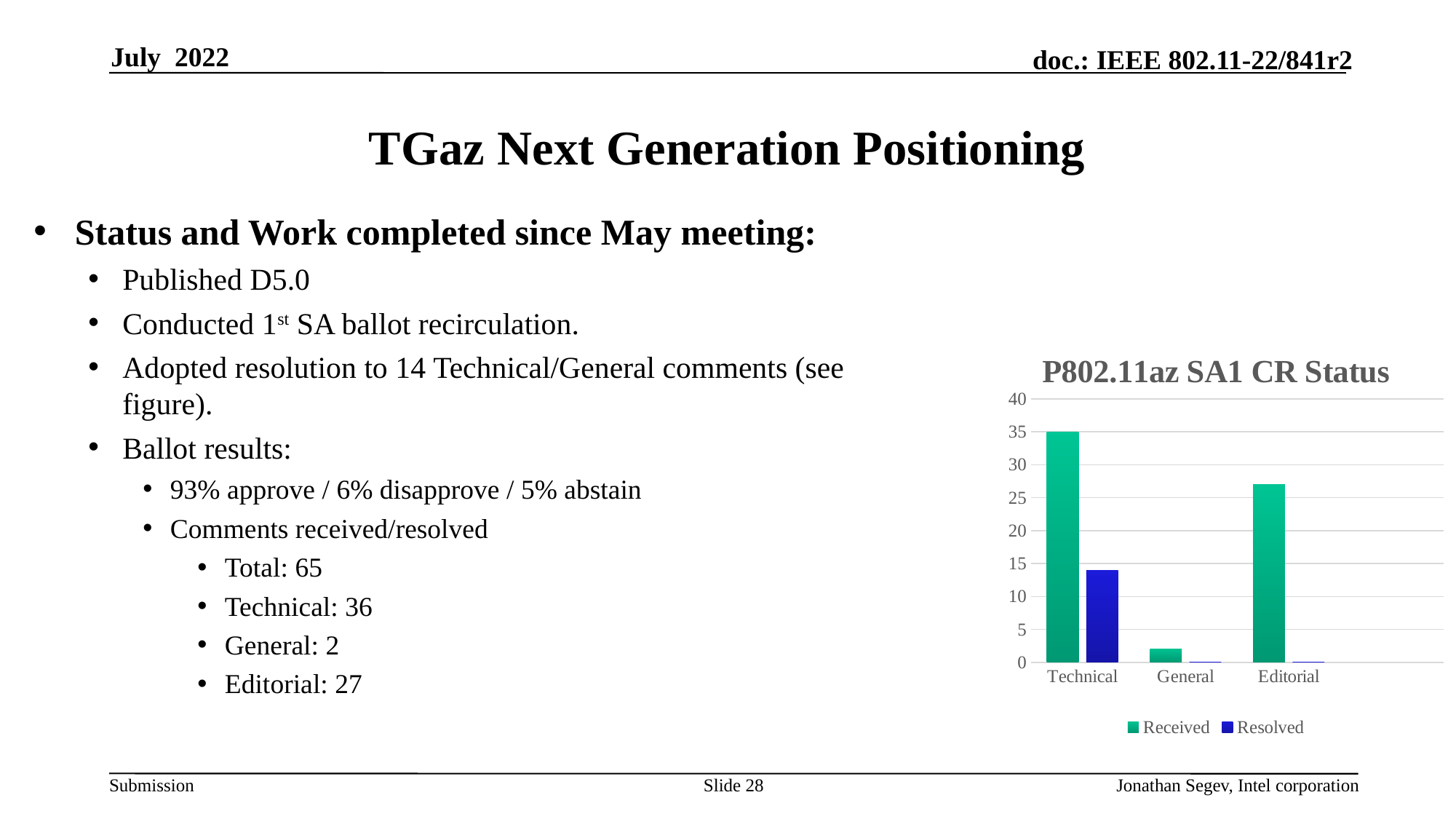
What are the two legend entries of the P802.11az SA1 CR Status chart? Received and Resolved How many categories are shown on the x axis of the P802.11az SA1 CR Status chart? 3 Is the Resolved value for Technical greater or less than 10? greater Which is larger in the P802.11az SA1 CR Status chart: the Received value for Editorial or the Received value for General? Editorial Which category has the lowest Received value in the P802.11az SA1 CR Status chart? General Is the Received value for General greater or less than 5? less Which category has the highest Resolved value in the P802.11az SA1 CR Status chart? Technical Is the Received value for Editorial greater or less than 25? greater How many series does the legend of the P802.11az SA1 CR Status chart list? 2 What kind of chart is shown under the title "P802.11az SA1 CR Status"? bar chart Which category has the highest Received value in the P802.11az SA1 CR Status chart? Technical